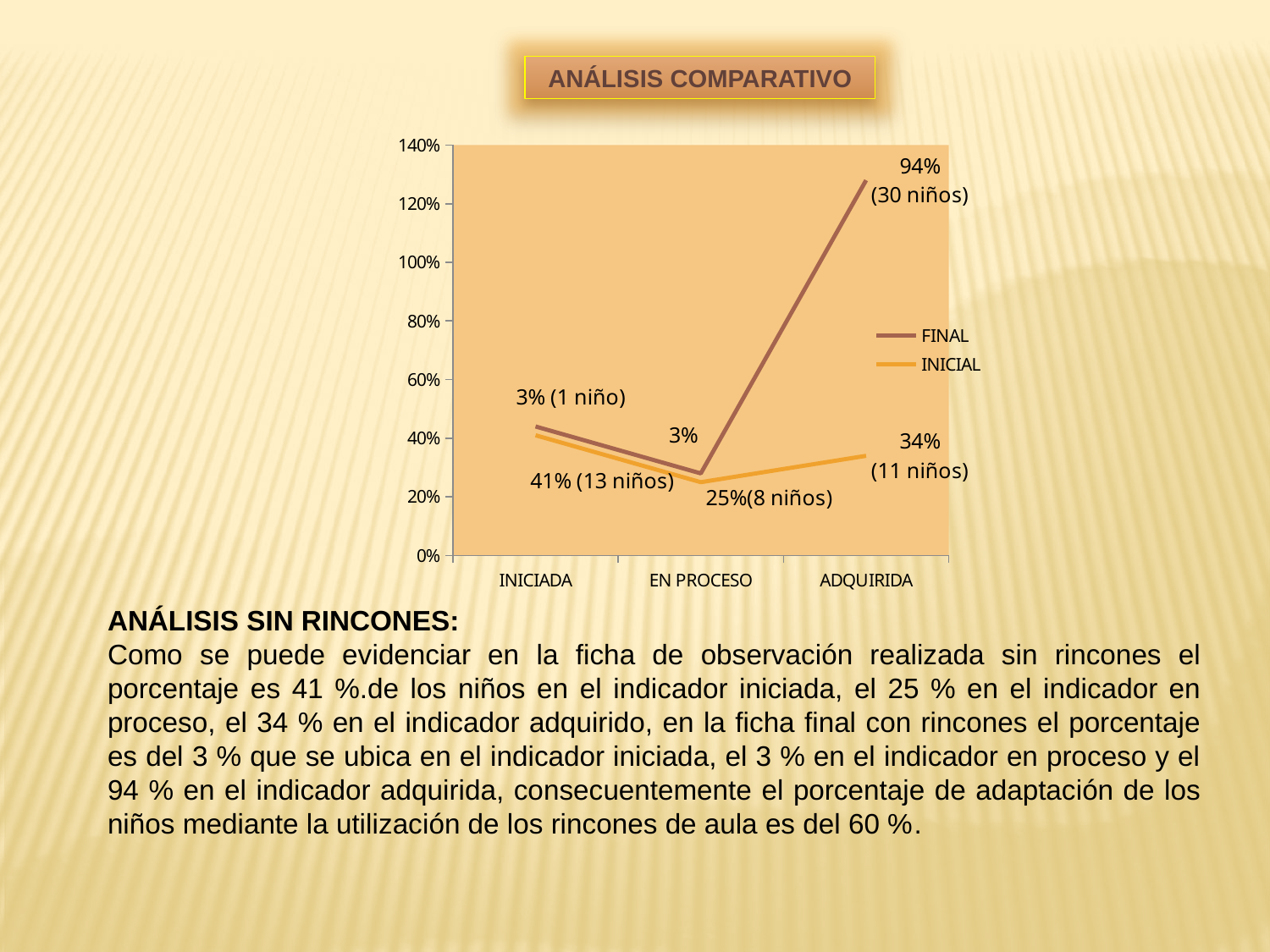
Which category has the lowest INICIAL value? EN PROCESO For ADQUIRIDA, which series has the larger value, FINAL or INICIAL? FINAL How many categories are shown on the x axis of the chart? 3 What is the title shown above the chart? ANÁLISIS COMPARATIVO What is the difference in percentage points between the FINAL and INICIAL values for ADQUIRIDA? 60 What type of chart is shown on the slide? Line chart What is the FINAL value labelled for ADQUIRIDA? 94% (30 niños) How many series does the chart legend list? 2 What is the INICIAL value labelled for EN PROCESO? 25%(8 niños) Which category has the highest FINAL value? ADQUIRIDA What is the FINAL value labelled for INICIADA? 3% (1 niño) What is the INICIAL value labelled for INICIADA? 41% (13 niños)